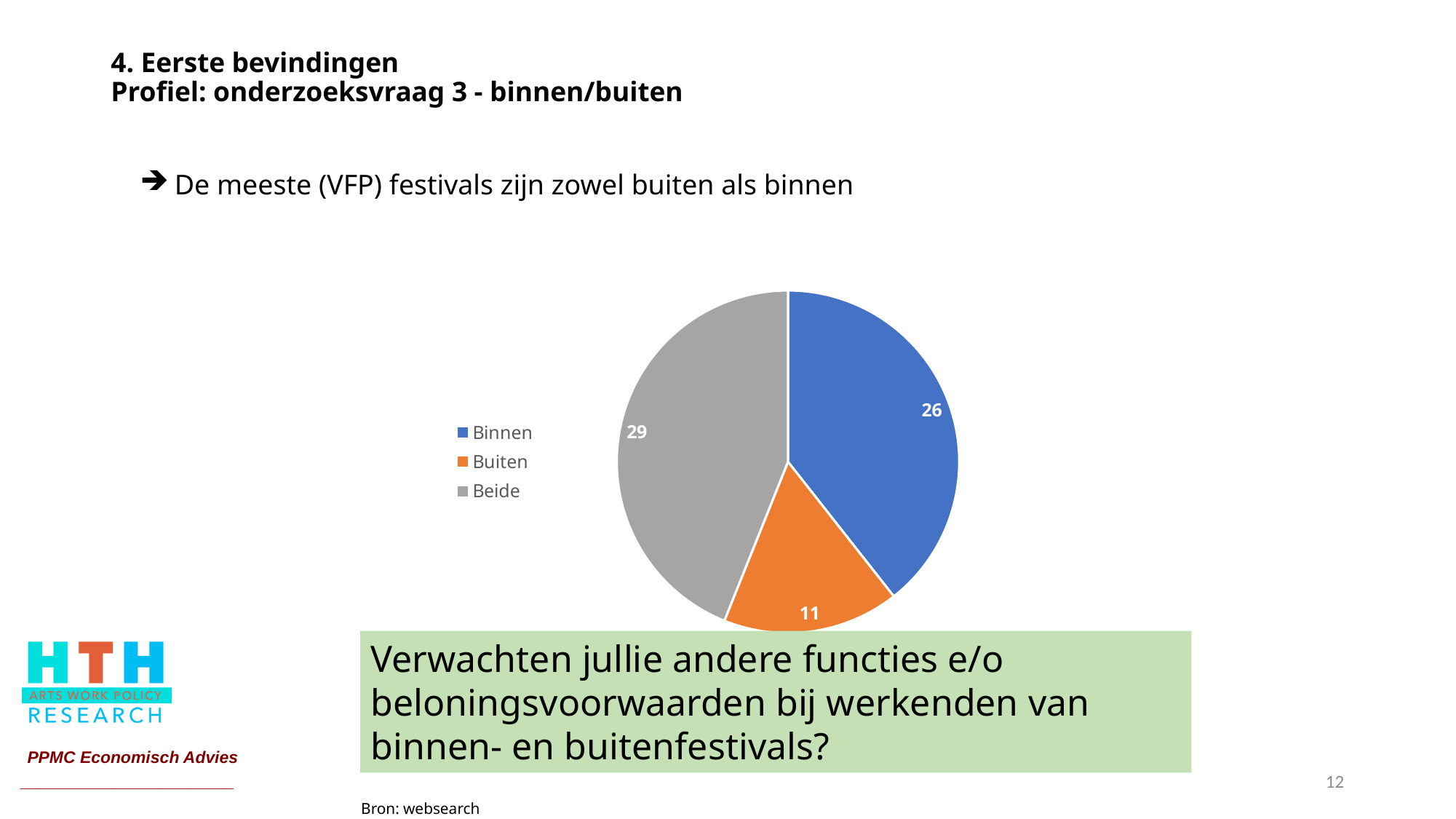
What is the value for Buiten in the pie chart? 11 What is the value for Beide in the pie chart? 29 What is the difference between the values for Binnen and Buiten? 15 Which category has the smallest slice in the pie chart? Buiten What is the difference between the values for Beide and Binnen? 3 Which is larger, the value for Binnen or the value for Buiten? Binnen Which colour represents Buiten in the pie chart? orange How many slices does the pie chart have? 3 What is the value for Binnen in the pie chart? 26 What is the total of all slices in the pie chart? 66 What type of chart is shown on the slide? pie chart Which category has the largest slice in the pie chart? Beide